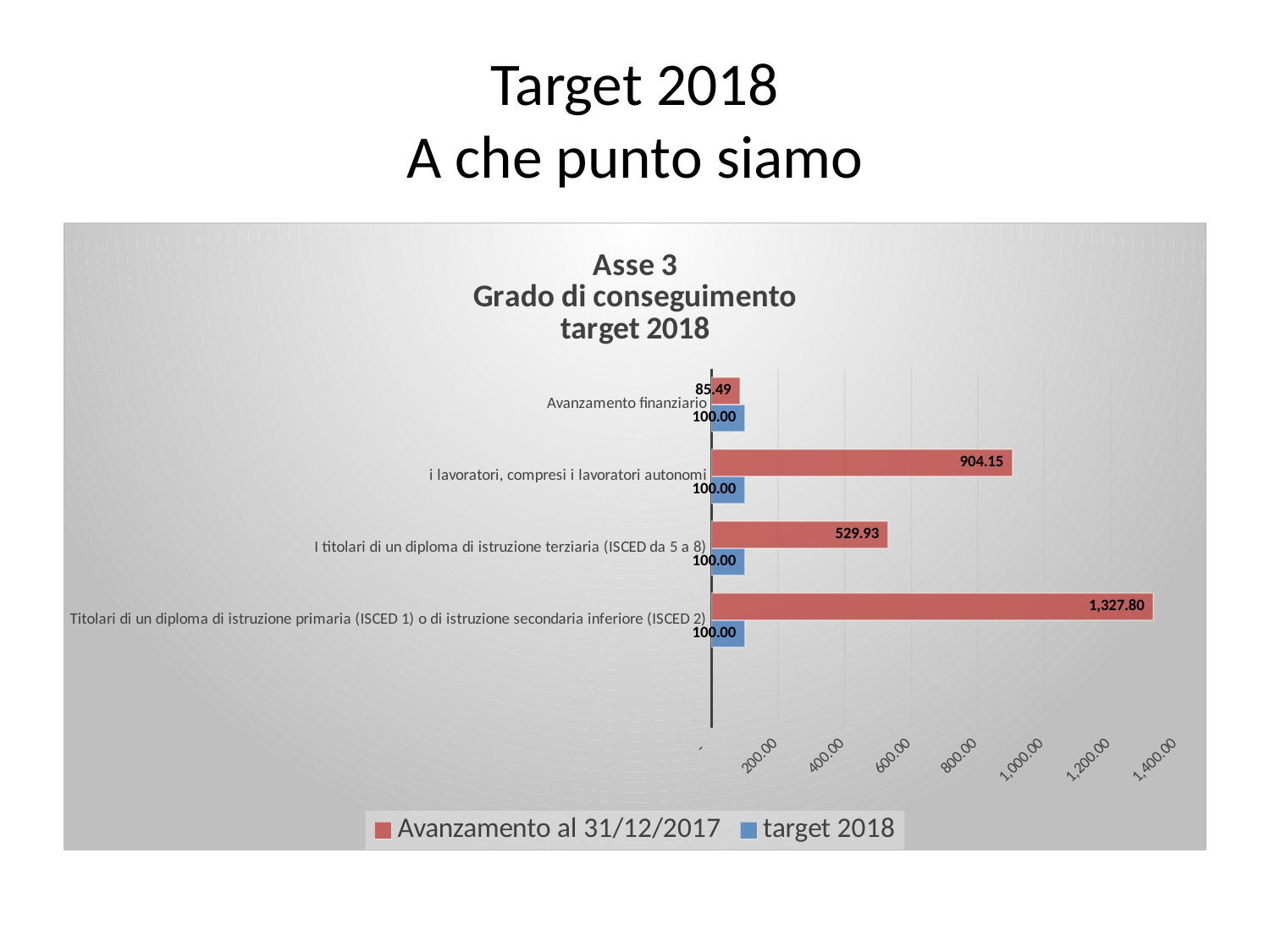
Is the 'Avanzamento al 31/12/2017' value for 'Avanzamento finanziario' larger or smaller than its 'target 2018' value? smaller What is the title of the chart? Asse 3 Grado di conseguimento target 2018 What is the value of 'Avanzamento al 31/12/2017' for 'i lavoratori, compresi i lavoratori autonomi'? 904.15 What is the value of 'Avanzamento al 31/12/2017' for 'Avanzamento finanziario'? 85.49 How many categories are shown on the chart? 4 Is the 'Avanzamento al 31/12/2017' value for 'i lavoratori, compresi i lavoratori autonomi' greater or less than 800.00? greater Which category has the lowest 'Avanzamento al 31/12/2017' value? Avanzamento finanziario What is the difference between the 'Avanzamento al 31/12/2017' value and the 'target 2018' value for 'I titolari di un diploma di istruzione terziaria (ISCED da 5 a 8)'? 429.93 How many series does the legend list? 2 Which category has the highest 'Avanzamento al 31/12/2017' value? Titolari di un diploma di istruzione primaria (ISCED 1) o di istruzione secondaria inferiore (ISCED 2) What is the 'target 2018' value for 'I titolari di un diploma di istruzione terziaria (ISCED da 5 a 8)'? 100.00 What type of chart is shown on the slide? bar chart